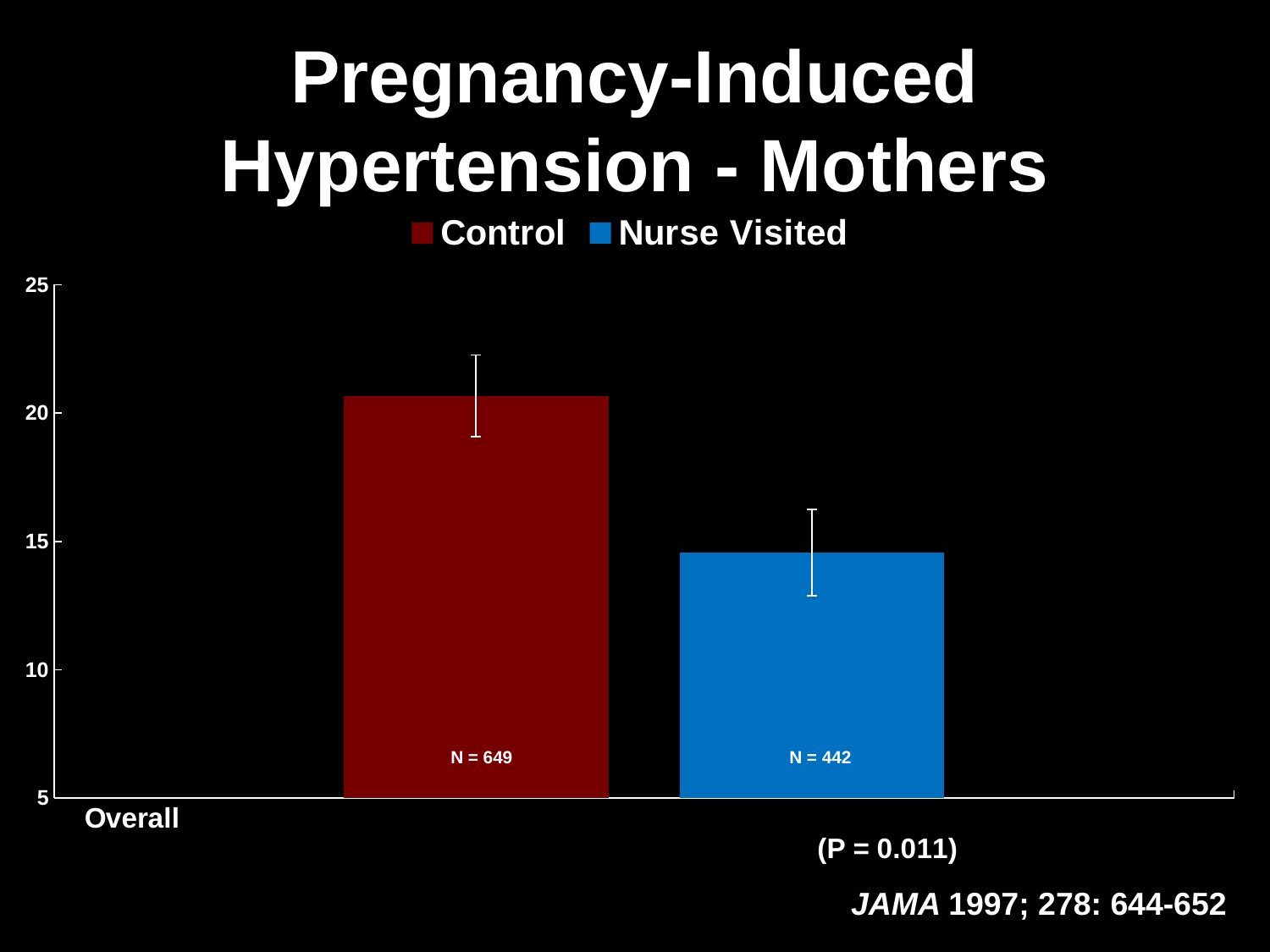
Is the value for Control greater or less than 15? greater What are the two series named in the legend? Control and Nurse Visited Which series has the lowest bar? Nurse Visited Which series has the higher bar, Control or Nurse Visited? Control What is the N printed on the Control bar? N = 649 What is the N printed on the Nurse Visited bar? N = 442 How many series does the legend list? 2 What is the label of the category on the x axis? Overall How many categories are shown on the x axis? 1 Is the value for Nurse Visited greater or less than 20? less Which series has the highest bar? Control What kind of chart is shown on the slide? Bar chart